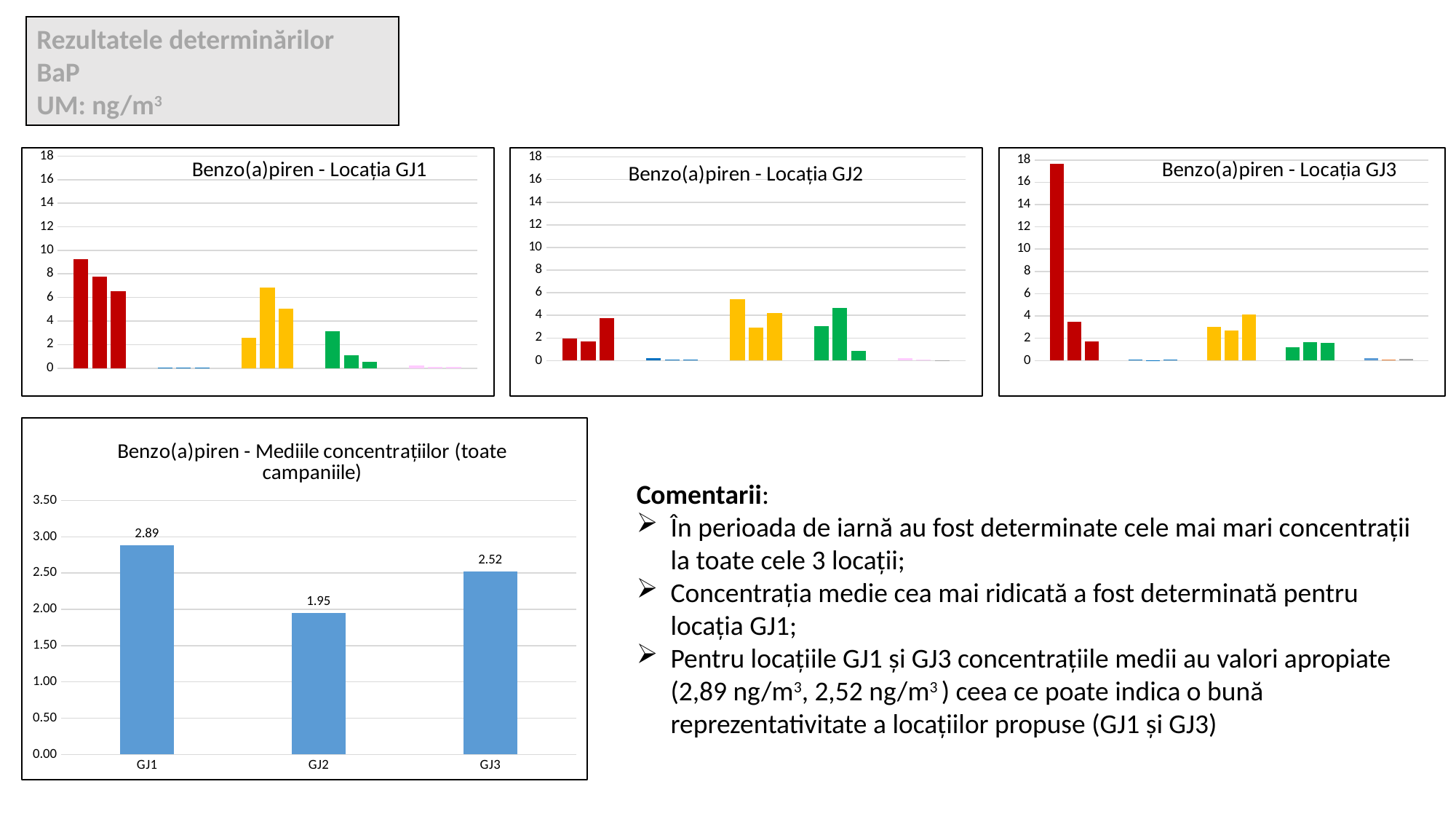
How many locations are shown in the chart 'Benzo(a)piren - Mediile concentrațiilor (toate campaniile)'? 3 In the chart 'Benzo(a)piren - Mediile concentrațiilor (toate campaniile)', what is the difference between the values for GJ3 and GJ2? 0.57 In the chart 'Benzo(a)piren - Mediile concentrațiilor (toate campaniile)', what is the value for GJ2? 1.95 In the chart 'Benzo(a)piren - Mediile concentrațiilor (toate campaniile)', what is the value for GJ3? 2.52 In the chart 'Benzo(a)piren - Mediile concentrațiilor (toate campaniile)', what is the difference between the values for GJ1 and GJ3? 0.37 How many charts are shown on the slide? 4 In the chart 'Benzo(a)piren - Mediile concentrațiilor (toate campaniile)', what is the value for GJ1? 2.89 In the chart 'Benzo(a)piren - Mediile concentrațiilor (toate campaniile)', which is larger, the value for GJ2 or the value for GJ3? GJ3 In the chart 'Benzo(a)piren - Locația GJ3', is the tallest bar greater or less than 16? greater What kind of chart is 'Benzo(a)piren - Mediile concentrațiilor (toate campaniile)'? bar chart In the chart 'Benzo(a)piren - Mediile concentrațiilor (toate campaniile)', which location has the highest value? GJ1 In the chart 'Benzo(a)piren - Mediile concentrațiilor (toate campaniile)', which location has the lowest value? GJ2